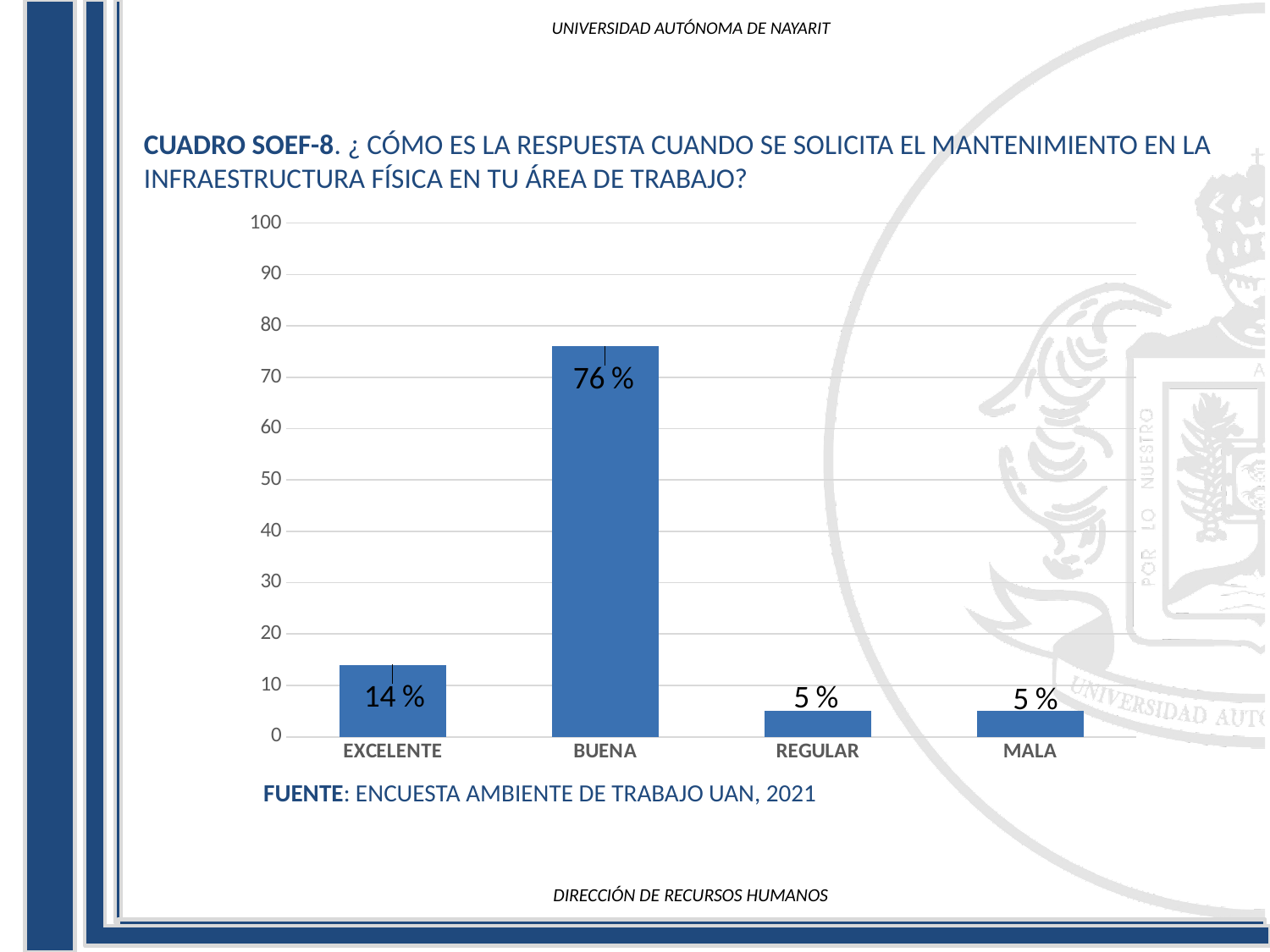
What source is cited below the chart? ENCUESTA AMBIENTE DE TRABAJO UAN, 2021 What is the value for MALA? 5 % Is the value for BUENA greater or less than 70? greater Which is larger, the value for EXCELENTE or the value for MALA? EXCELENTE How many categories are shown on the x axis? 4 What is the value for EXCELENTE? 14 % What is the value for REGULAR? 5 % What is the difference between the values for EXCELENTE and REGULAR? 9 % What is the value for BUENA? 76 % What is the difference between the values for BUENA and EXCELENTE? 62 % Which category has the highest value? BUENA What kind of chart is shown on the slide? bar chart